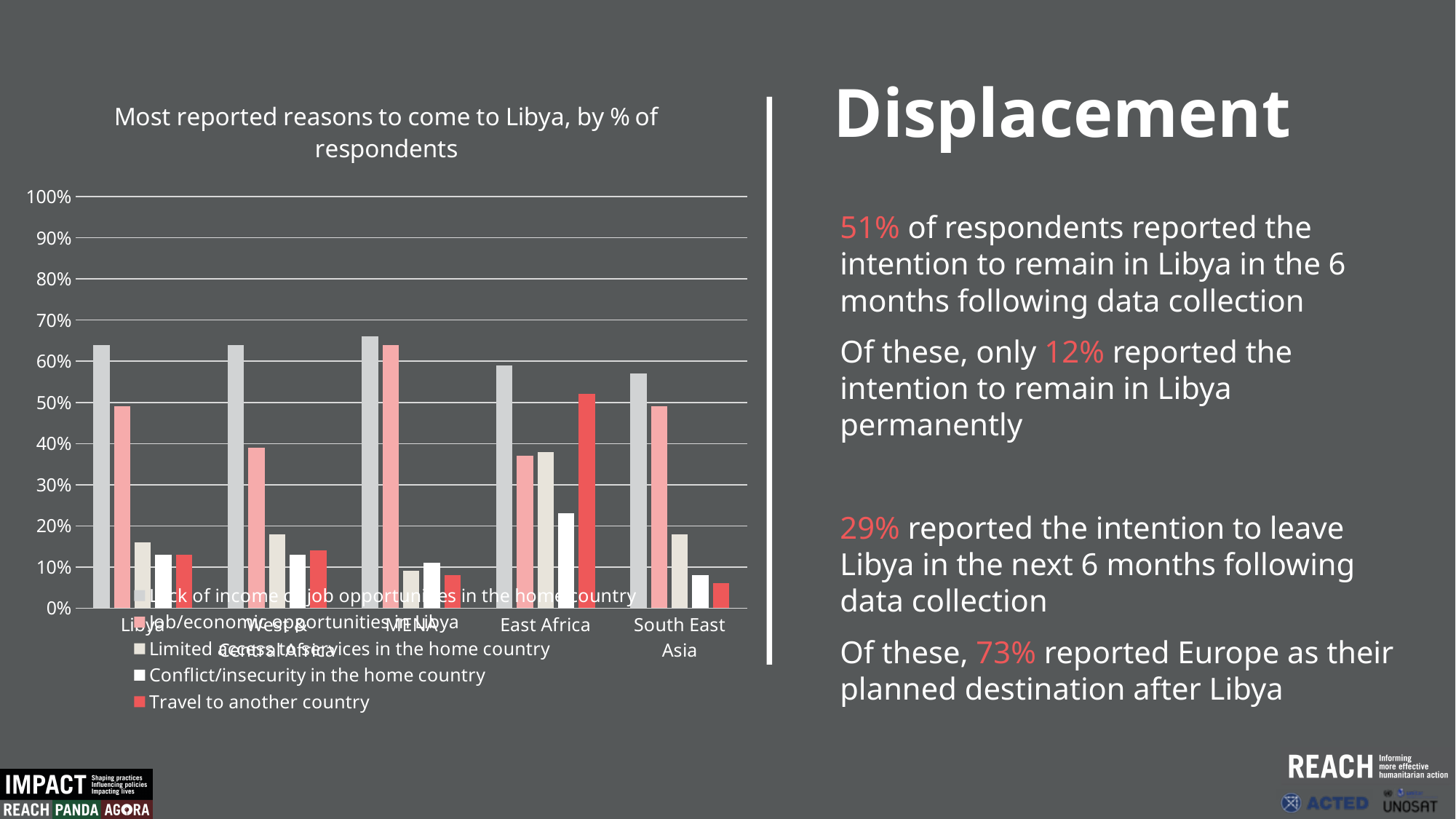
Is the value for 'Travel to another country' for East Africa greater or less than 40%? greater For Libya, which is larger: 'Job/economic opportunities in Libya' or 'Limited access to services in the home country'? Job/economic opportunities in Libya Is the value for 'Travel to another country' for MENA greater or less than 20%? less How many regions (categories) are shown on the x axis of the chart? 5 Is the value for 'Lack of income or job opportunities in the home country' for Libya greater or less than 60%? greater What kind of chart is shown on the slide? Bar chart Which region has the highest value for 'Travel to another country'? East Africa How many series does the chart's legend list? 5 What is the title of the chart? Most reported reasons to come to Libya, by % of respondents For East Africa, which is larger: 'Travel to another country' or 'Conflict/insecurity in the home country'? Travel to another country Which region has the highest value for 'Conflict/insecurity in the home country'? East Africa